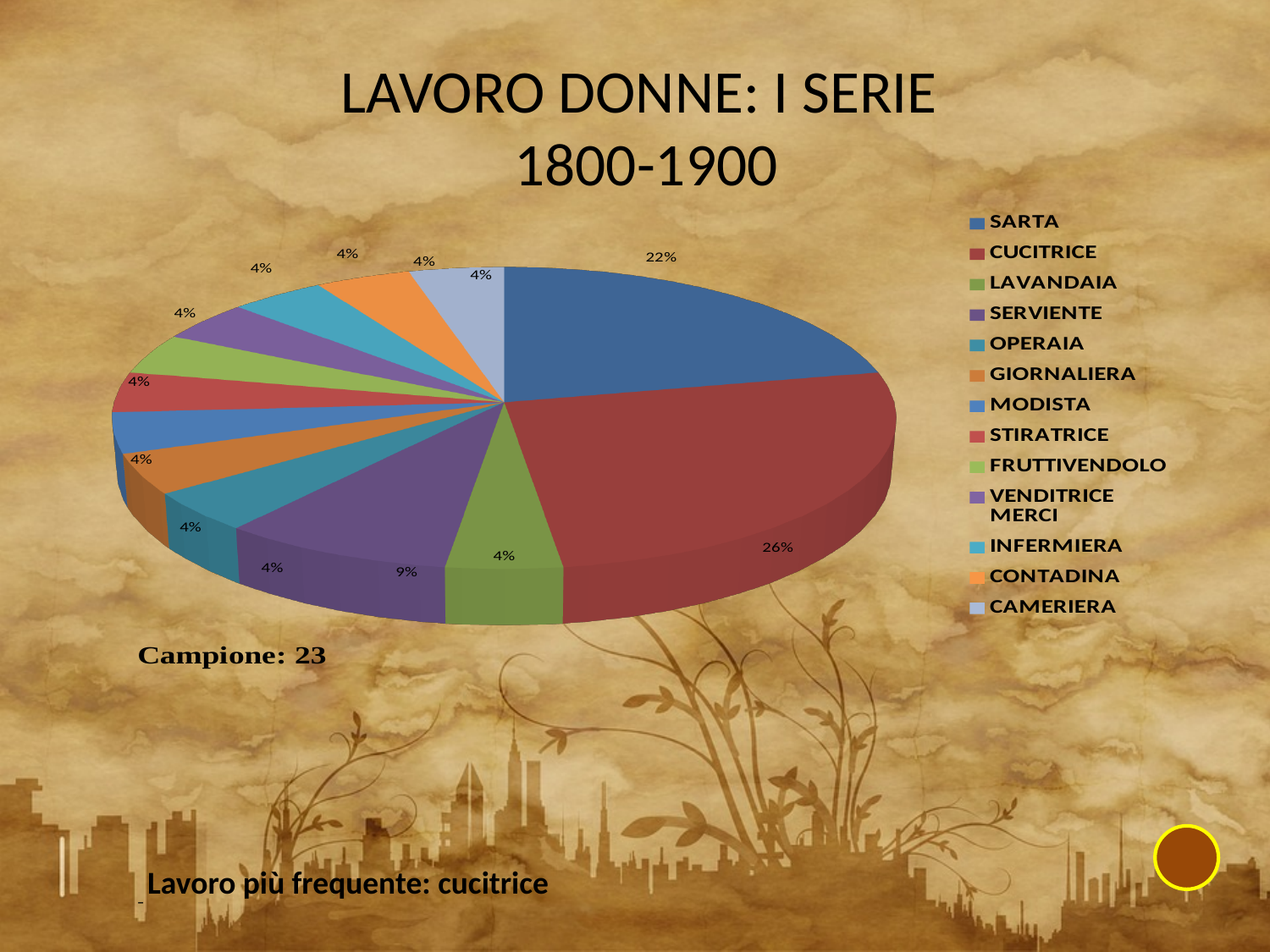
How many categories are listed in the chart legend? 13 What is the sample size (Campione) stated below the chart? 23 What percentage of the pie does CUCITRICE represent? 26% Which category has the largest slice of the pie? CUCITRICE What percentage of the pie does LAVANDAIA represent? 4% What is the difference in percentage points between SARTA and SERVIENTE? 13 What is the difference in percentage points between CUCITRICE and SARTA? 4 Which is larger, the slice for SERVIENTE or the slice for OPERAIA? SERVIENTE What percentage of the pie does SERVIENTE represent? 9% What is the title of the slide containing the chart? LAVORO DONNE: I SERIE 1800-1900 What type of chart is shown on the slide? pie chart